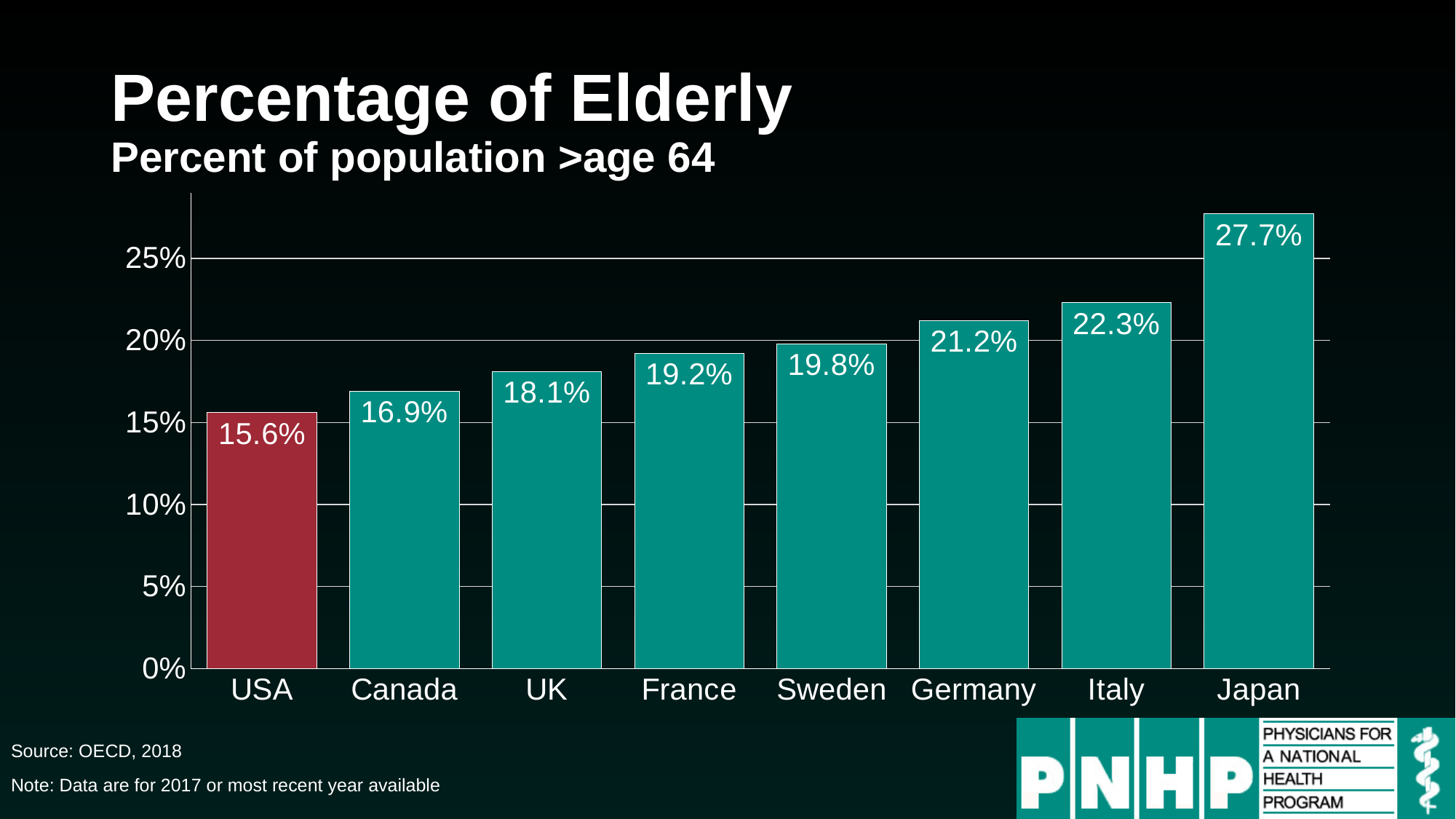
What is the percentage of population over age 64 for Japan? 27.7% What is the difference between Italy's and Canada's values? 5.4% What is the difference between Japan's and the USA's values? 12.1% Which bar is coloured differently from the others? USA How many countries are shown in the chart? 8 What kind of chart is shown on the slide? Bar chart Which has a higher value, Sweden or France? Sweden Which country has the highest percentage of elderly? Japan What is the value shown for the USA? 15.6% Is the value for the UK greater or less than 20%? less Which country has the lowest percentage of elderly? USA What is the value shown for Germany? 21.2%